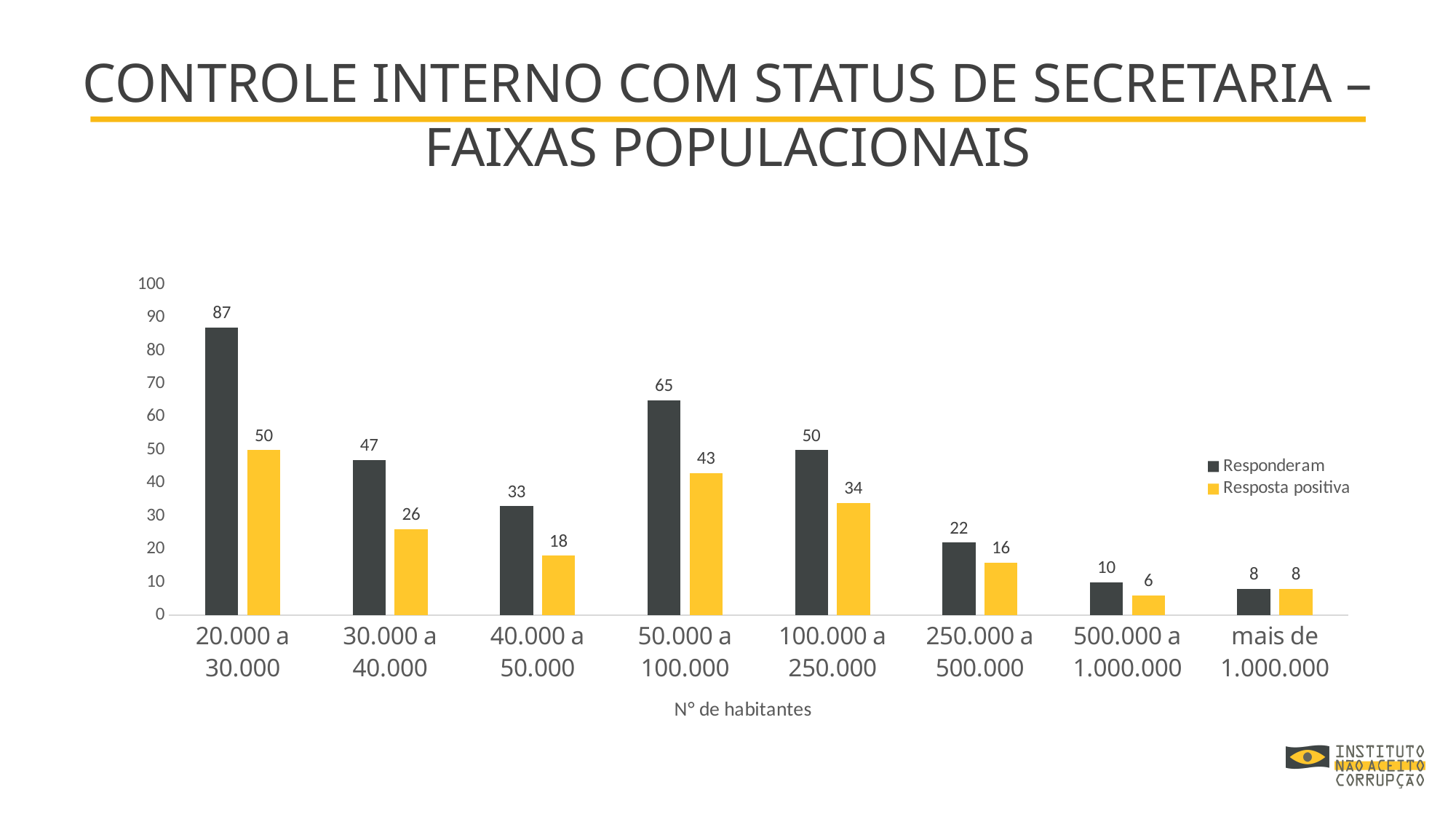
What is the x-axis title of the chart? N° de habitantes Which colour represents the Resposta positiva series? Yellow What kind of chart is shown on the slide? Bar chart What is the value of Responderam for the 250.000 a 500.000 category? 22 What is the difference between Responderam and Resposta positiva for the 100.000 a 250.000 category? 16 What is the value of Resposta positiva for the 50.000 a 100.000 category? 43 How many population categories are shown on the x axis? 8 What is the value of Responderam for the 20.000 a 30.000 category? 87 Which is larger: Resposta positiva for 30.000 a 40.000 or Resposta positiva for 40.000 a 50.000? 30.000 a 40.000 How many series does the legend list? 2 Which category has the lowest Resposta positiva value? 500.000 a 1.000.000 Which category has the highest Responderam value? 20.000 a 30.000